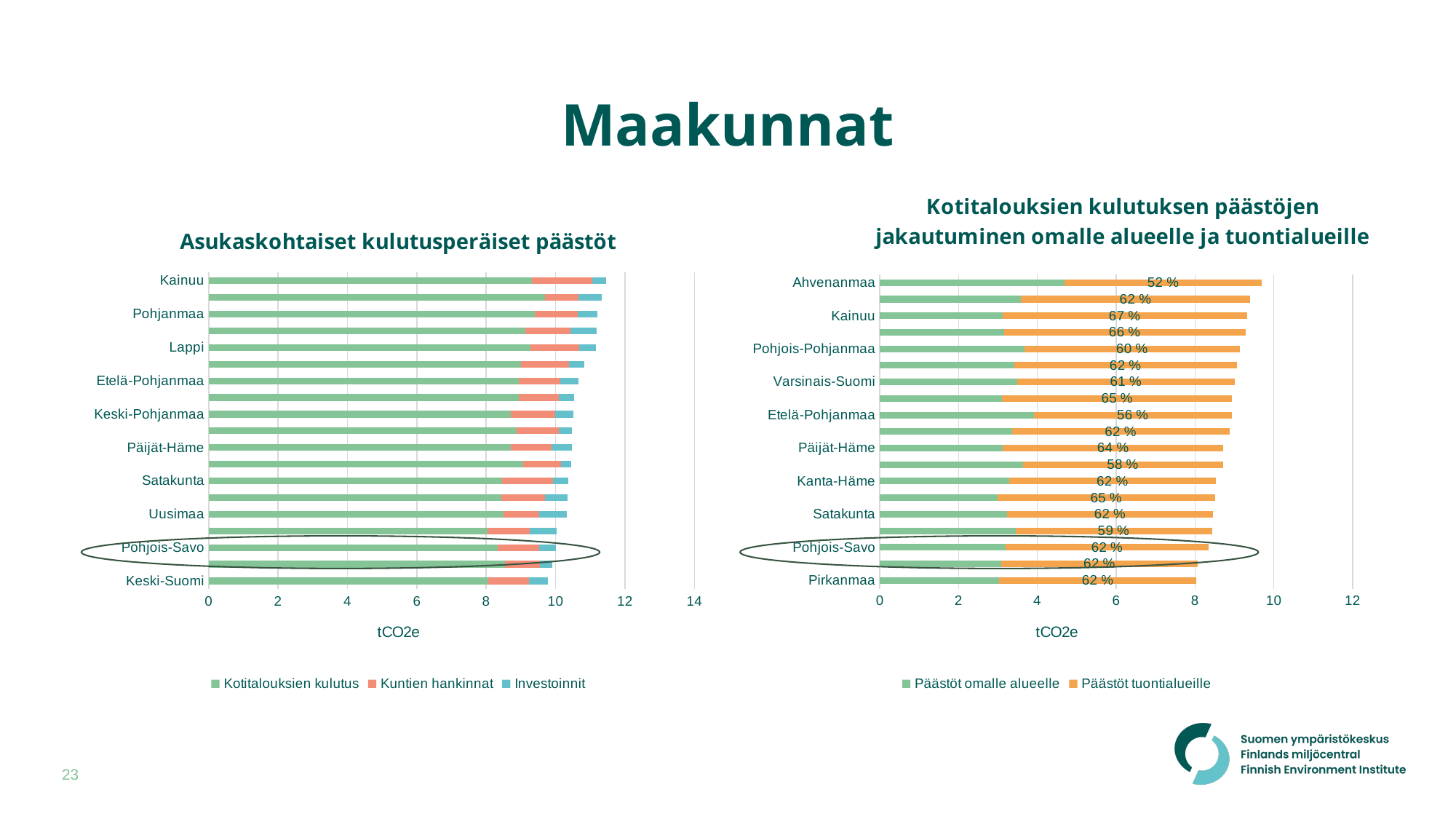
In the left chart 'Asukaskohtaiset kulutusperäiset päästöt', is the total value for Kainuu greater or less than 10 tCO2e? greater How many series does the legend of the right chart 'Kotitalouksien kulutuksen päästöjen jakautuminen omalle alueelle ja tuontialueille' list? 2 In the left chart 'Asukaskohtaiset kulutusperäiset päästöt', which labelled region has the lowest total emissions? Keski-Suomi In the right chart 'Kotitalouksien kulutuksen päästöjen jakautuminen omalle alueelle ja tuontialueille', is the total bar length for Ahvenanmaa greater or less than 8 tCO2e? greater In the right chart 'Kotitalouksien kulutuksen päästöjen jakautuminen omalle alueelle ja tuontialueille', what percentage is labelled for Kainuu? 67 % In the right chart 'Kotitalouksien kulutuksen päästöjen jakautuminen omalle alueelle ja tuontialueille', what percentage is labelled for Ahvenanmaa? 52 % In the left chart 'Asukaskohtaiset kulutusperäiset päästöt', what is the unit shown on the x axis? tCO2e In the right chart 'Kotitalouksien kulutuksen päästöjen jakautuminen omalle alueelle ja tuontialueille', what percentage is labelled for Etelä-Pohjanmaa? 56 % How many series does the legend of the left chart 'Asukaskohtaiset kulutusperäiset päästöt' list? 3 What kind of chart is the left chart, 'Asukaskohtaiset kulutusperäiset päästöt'? Stacked bar chart In the right chart 'Kotitalouksien kulutuksen päästöjen jakautuminen omalle alueelle ja tuontialueille', what is the difference in percentage points between the labels for Kainuu and Ahvenanmaa? 15 percentage points In the left chart 'Asukaskohtaiset kulutusperäiset päästöt', which labelled region has the highest total emissions? Kainuu